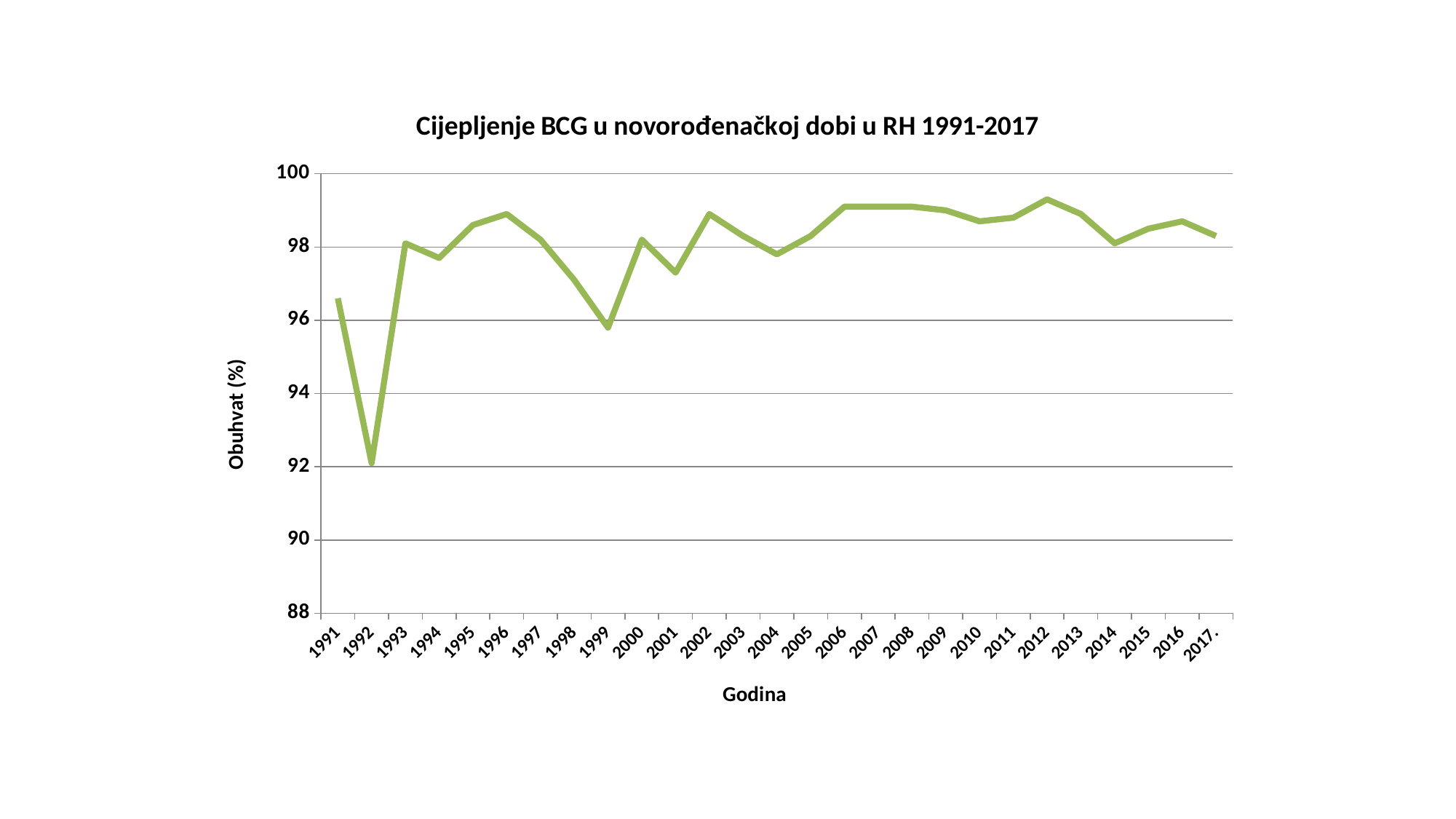
Is the value for 1992 greater or less than 94? less Is the value for 2012 greater or less than 98? greater Is the value for 2001 greater or less than 98? less What kind of chart is shown on the slide? line chart Which year has the lowest BCG vaccination coverage? 1992 Which year has the higher coverage, 1999 or 2000? 2000 How many years are plotted on the x axis? 27 Does the coverage rise or fall from 1992 to 1996? rise Which year has the higher coverage, 1992 or 1993? 1993 What is the label of the y axis? Obuhvat (%)